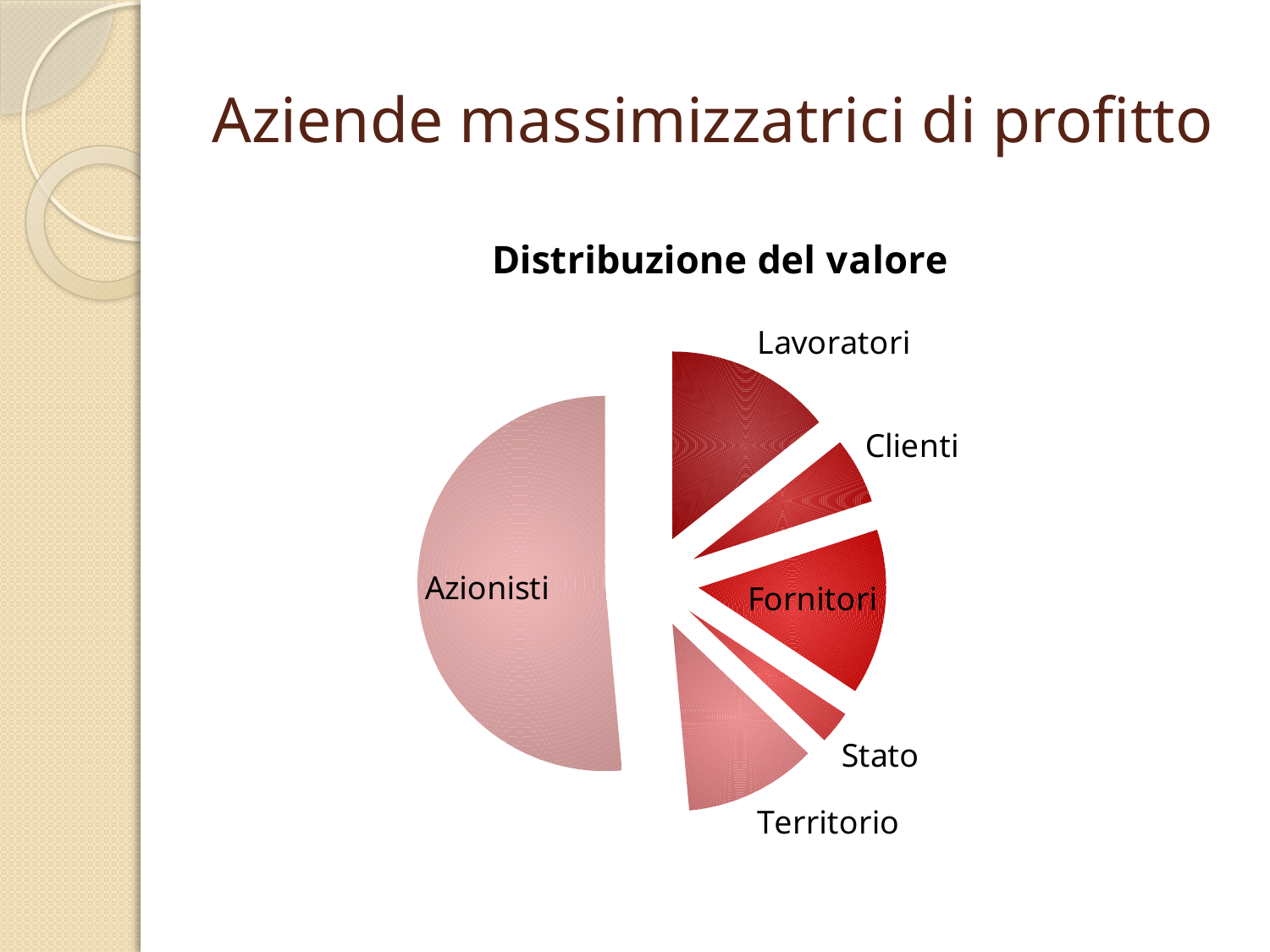
Which is larger, the slice for Azionisti or the slice for Territorio? Azionisti Which slice is labelled directly inside the pie on the right-hand side? Fornitori What kind of chart is shown on the slide? pie chart Which is larger, the slice for Lavoratori or the slice for Stato? Lavoratori Which is larger, the slice for Fornitori or the slice for Stato? Fornitori How many slices does the pie chart have? 6 Which category has the largest slice of the pie? Azionisti What is the title of the chart? Distribuzione del valore